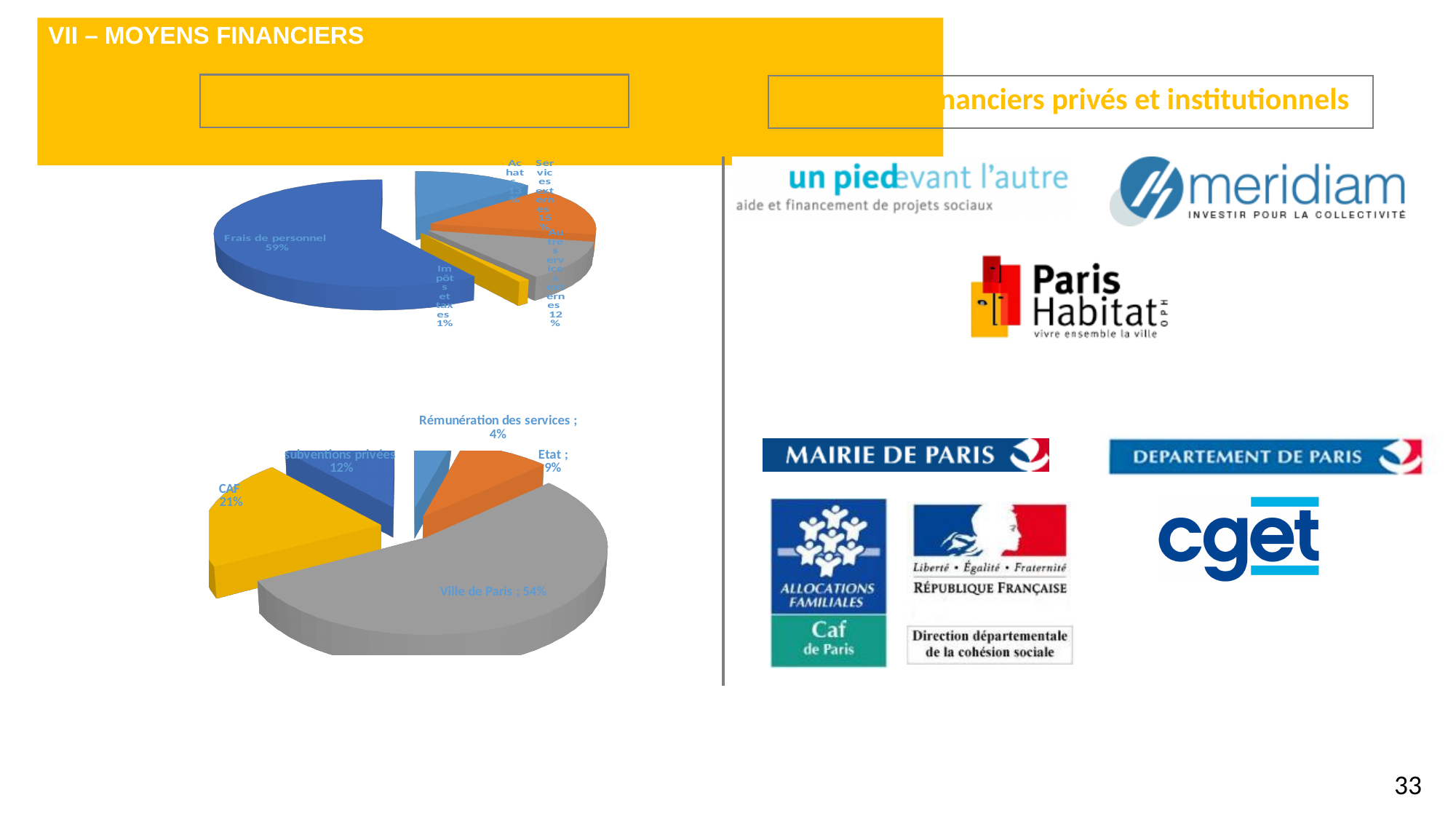
In the bottom pie chart, which category has the smallest share? Rémunération des services In the top pie chart, what percentage is attributed to Impôts et taxes? 1% In the top pie chart, which category has the largest share? Frais de personnel What type of chart is the bottom chart on the left side of the slide? Pie chart In the bottom pie chart, which category has the largest share? Ville de Paris In the bottom pie chart, what share does Ville de Paris represent? 54% In the bottom pie chart, what percentage is attributed to Etat? 9% In the bottom pie chart, what is the difference in percentage points between CAF and Subventions privées? 9 percentage points In the bottom pie chart, which is larger: Etat or Subventions privées? Subventions privées In the bottom pie chart, what percentage is attributed to CAF? 21% In the top pie chart, what share does Frais de personnel represent? 59% How many slices does the bottom pie chart have? 5